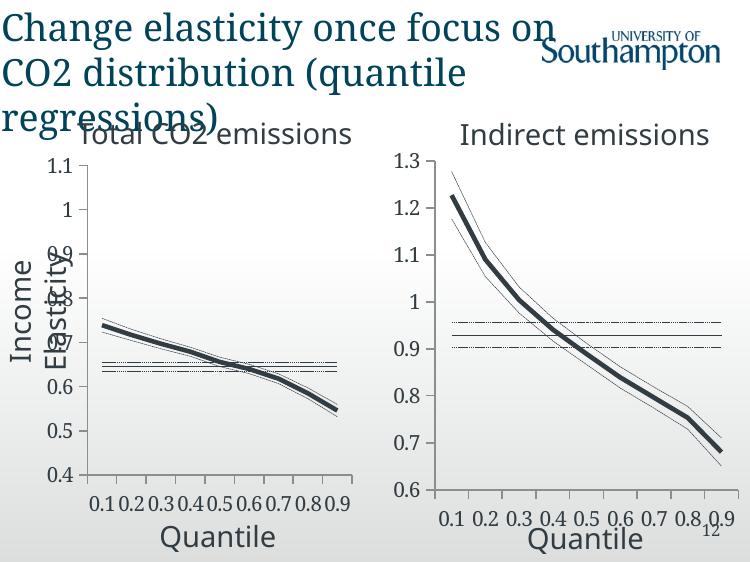
In the 'Total CO2 emissions' chart, at which quantile is the thick line highest? 0.1 In the 'Total CO2 emissions' chart, is the thick line's value at quantile 0.1 greater or less than 0.7? greater What kind of chart is the 'Indirect emissions' chart? line chart In the 'Indirect emissions' chart, at which quantile is the thick line lowest? 0.9 In the 'Total CO2 emissions' chart, does the thick line rise or fall as the quantile increases from 0.1 to 0.9? fall How many quantile points are shown on the x axis of the 'Indirect emissions' chart? 9 In the 'Indirect emissions' chart, is the thick line's value at quantile 0.1 greater or less than 1.1? greater In the 'Indirect emissions' chart, is the thick line's value at quantile 0.9 greater or less than 0.7? less What kind of chart is the 'Total CO2 emissions' chart? line chart In the 'Indirect emissions' chart, does the thick line rise or fall as the quantile increases from 0.1 to 0.9? fall What is the x-axis title of the 'Total CO2 emissions' chart? Quantile